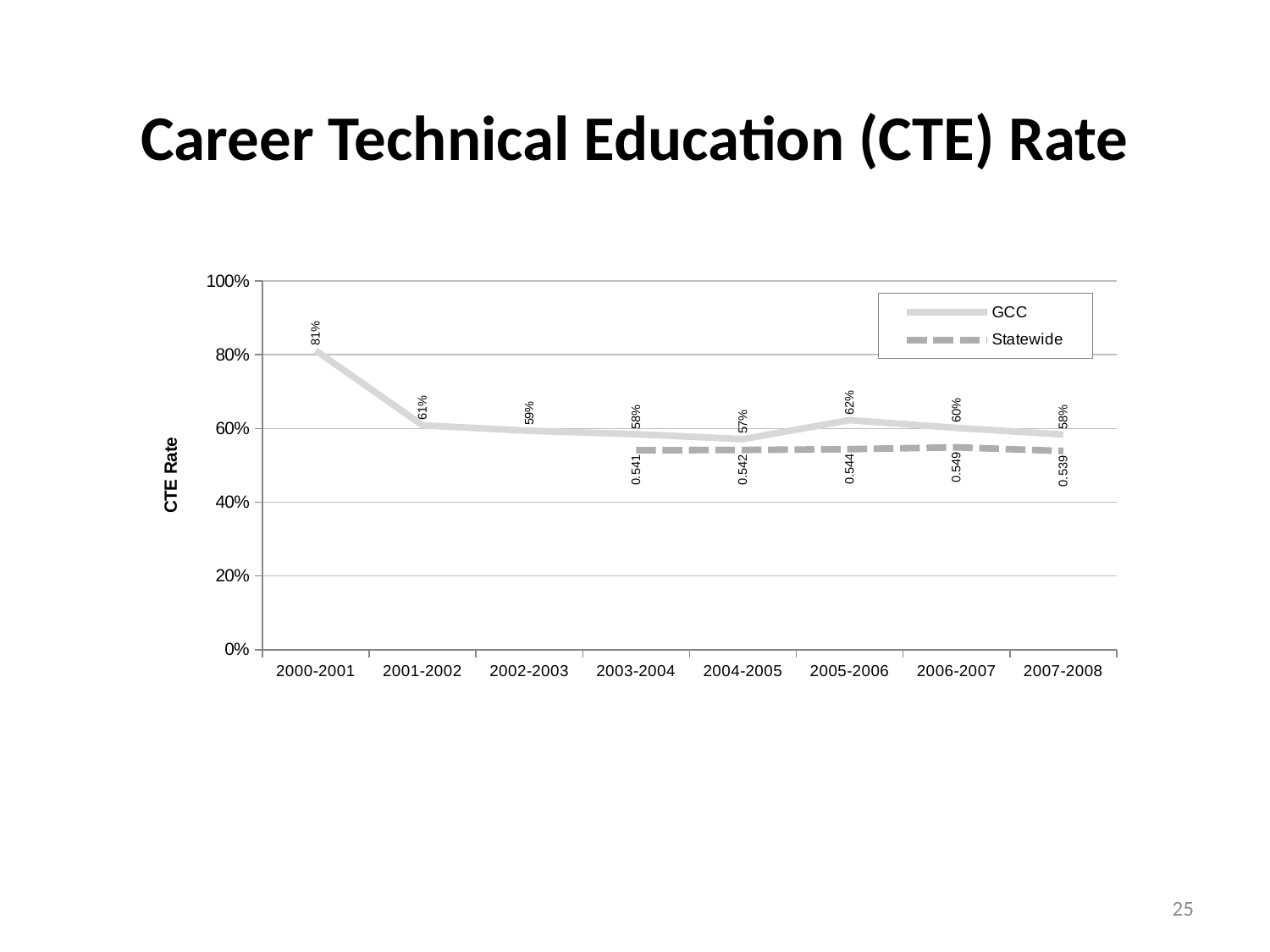
What kind of chart is shown on the slide? Line chart What is the Statewide value for 2006-2007? 0.549 What is the GCC value for 2005-2006? 62% What is the GCC value for 2000-2001? 81% What is the difference between the GCC values for 2000-2001 and 2001-2002? 20% What is the Statewide value for 2003-2004? 0.541 How many years are shown on the x axis? 8 In which year is the GCC value highest? 2000-2001 What is the label on the vertical axis? CTE Rate In which year is the GCC value lowest? 2004-2005 Which is larger in 2005-2006, the GCC value or the Statewide value? GCC How many series does the legend list? 2